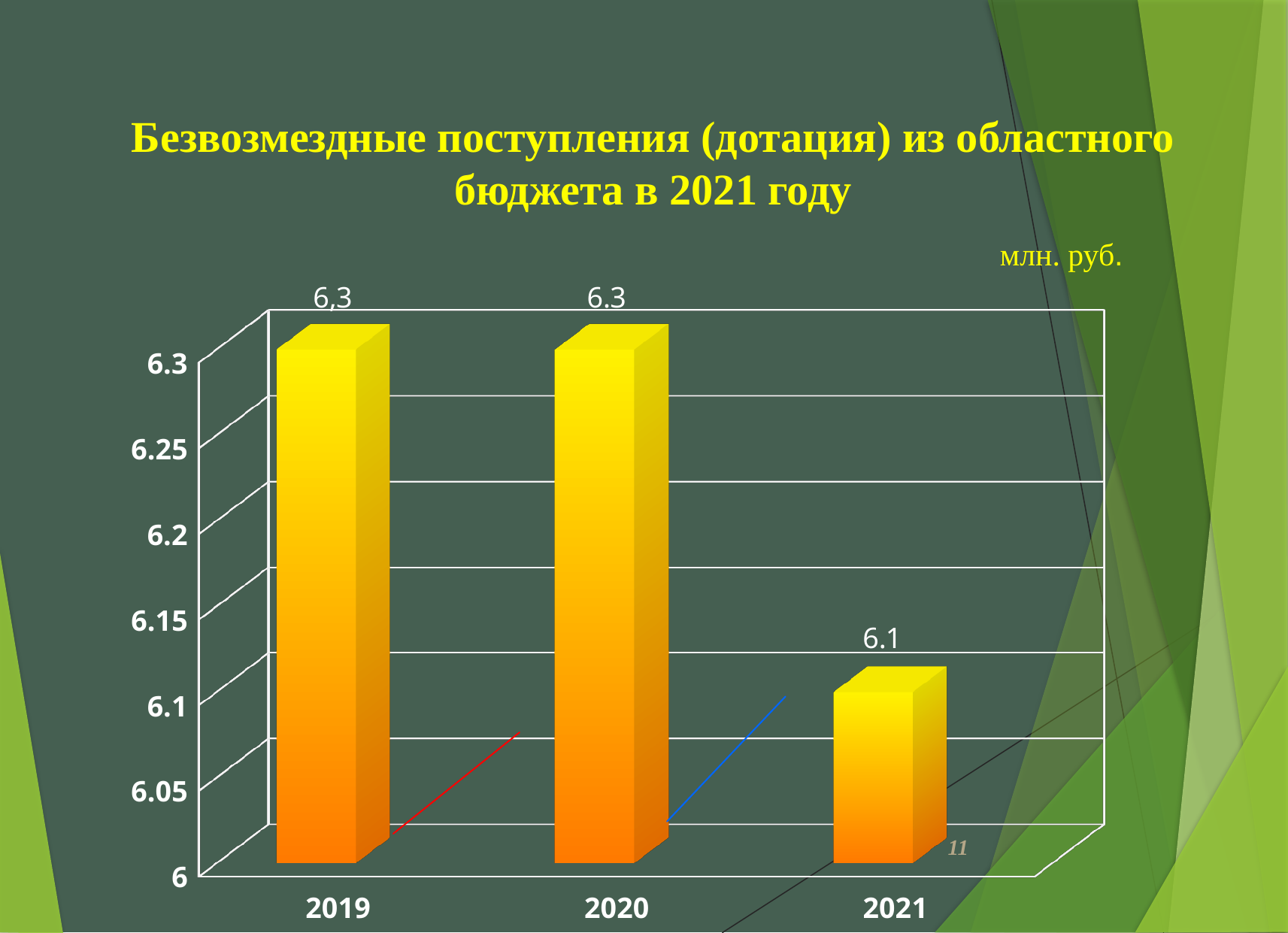
What is the title of the slide? Безвозмездные поступления (дотация) из областного бюджета в 2021 году Which is larger, the value for 2019 or the value for 2021? 2019 What unit of measurement is indicated above the chart? млн. руб. What is the value for 2021? 6.1 What is the difference between the values for 2020 and 2021? 0.2 Is the value for 2021 greater or less than 6.2? less What is the value for 2019? 6,3 Which year has the lowest value? 2021 What is the value for 2020? 6.3 How many years are shown on the x axis? 3 What kind of chart is shown on the slide? bar chart Do the values rise or fall from 2020 to 2021? fall